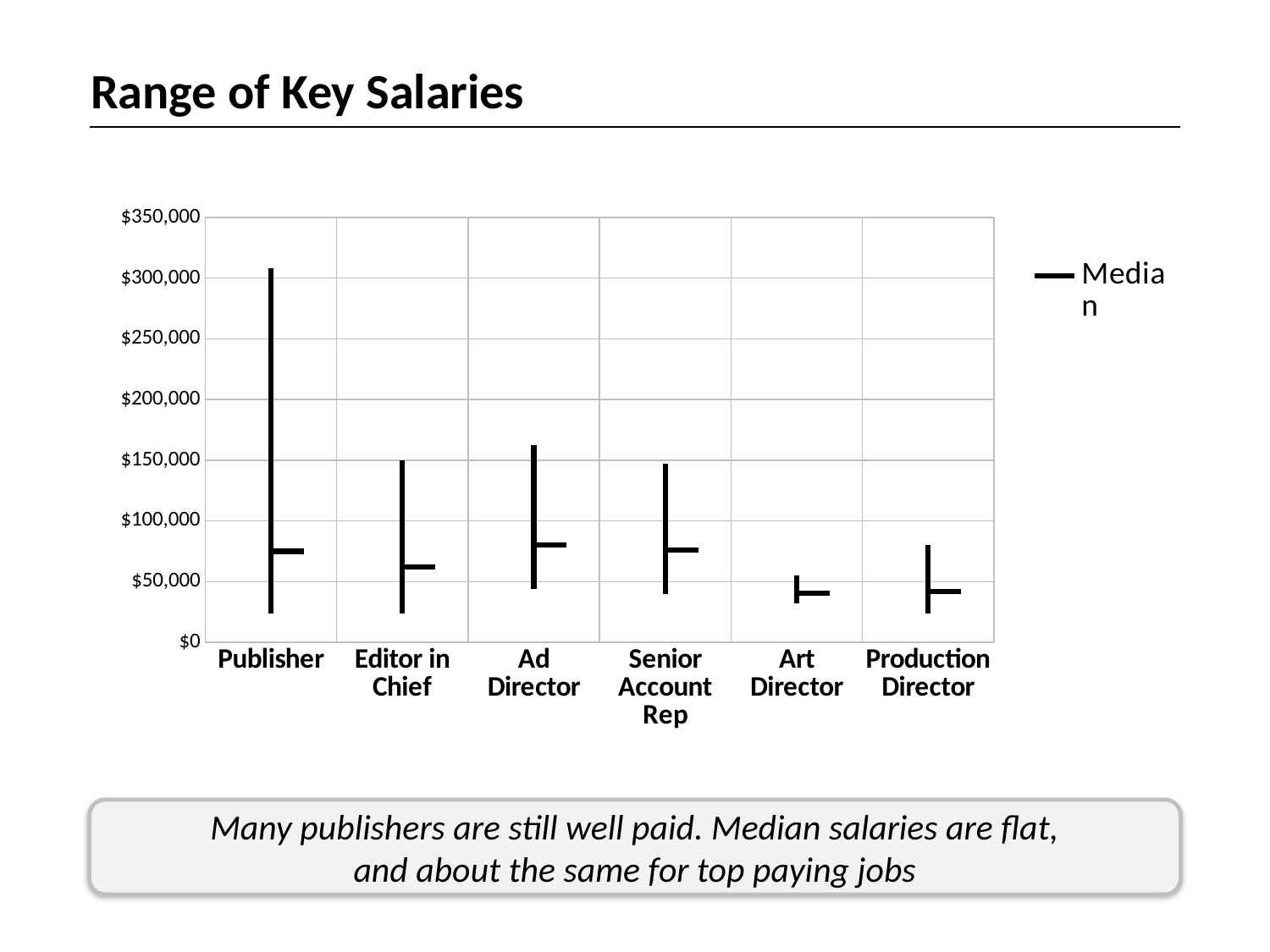
Which job category has the highest top of its salary range? Publisher Is the top of the salary range for Ad Director greater or less than $150,000? greater Is the top of the salary range for Art Director greater or less than $100,000? less Is the median salary for Art Director greater or less than $50,000? less What kind of chart is shown on the slide? high-low line chart What is the highest value shown on the y axis of the chart? $350,000 Which job category has the lowest top of its salary range? Art Director How many job categories are shown on the x axis of the chart? 6 How many series does the chart legend list? 1 What is the name of the series listed in the chart legend? Median Which has a higher top of salary range, Ad Director or Production Director? Ad Director